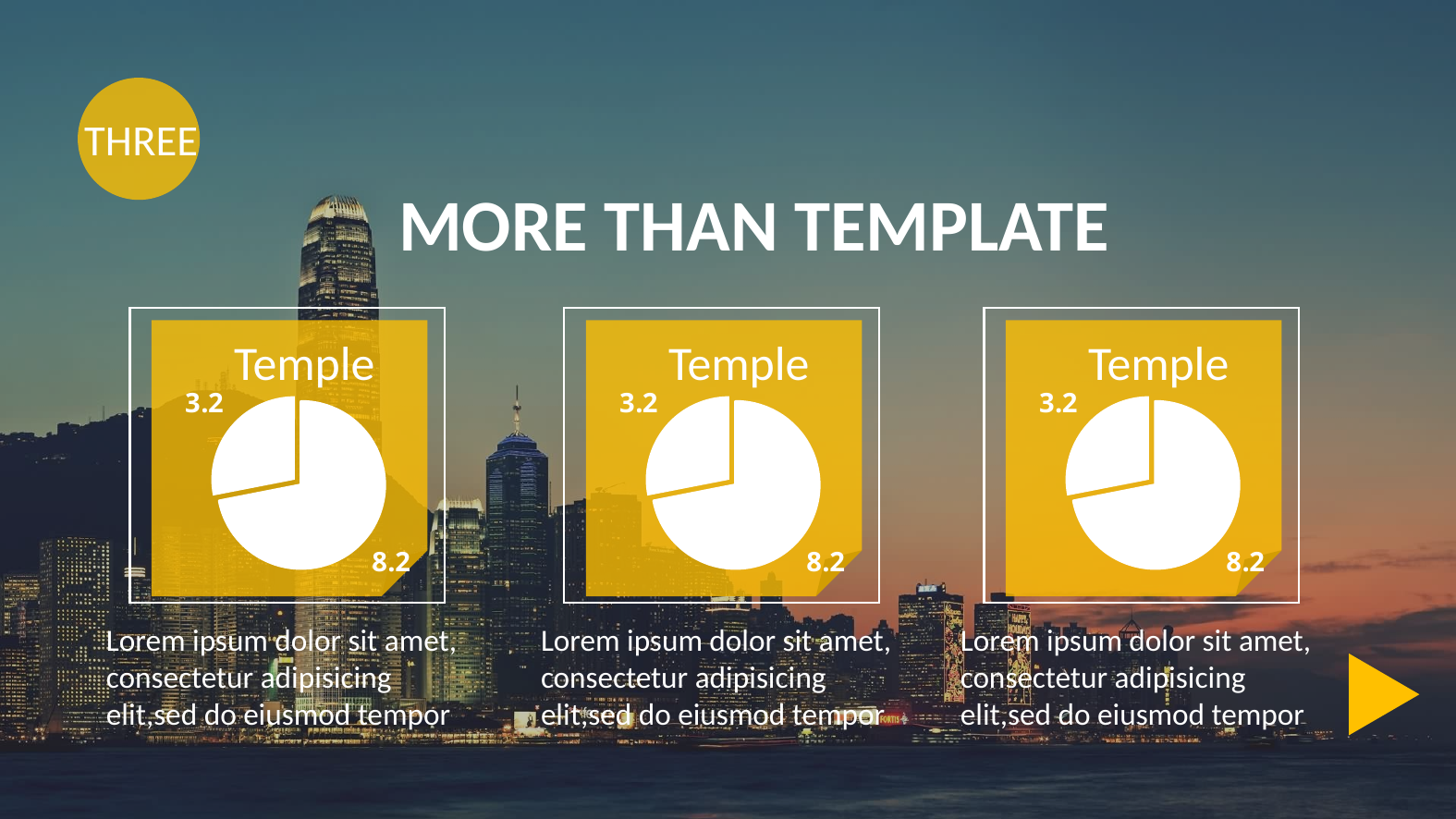
In the left-hand pie chart, what is the value of the smaller slice? 3.2 How many slices does the middle pie chart have? 2 In the right-hand pie chart, what is the difference between the two slice values? 5.0 What is the title of the pie chart in the middle box? Temple What kind of chart is shown in the left-hand box on the slide? pie chart In the left-hand pie chart, what is the value of the larger slice? 8.2 In the middle pie chart, what is the value of the largest slice? 8.2 In the middle pie chart, which value is larger, 3.2 or 8.2? 8.2 How many pie charts are shown on the slide? 3 What colour is the larger slice in the right-hand pie chart? white In the right-hand pie chart, what is the total of the two slice values? 11.4 In the left-hand pie chart, what is the value of the smallest slice? 3.2